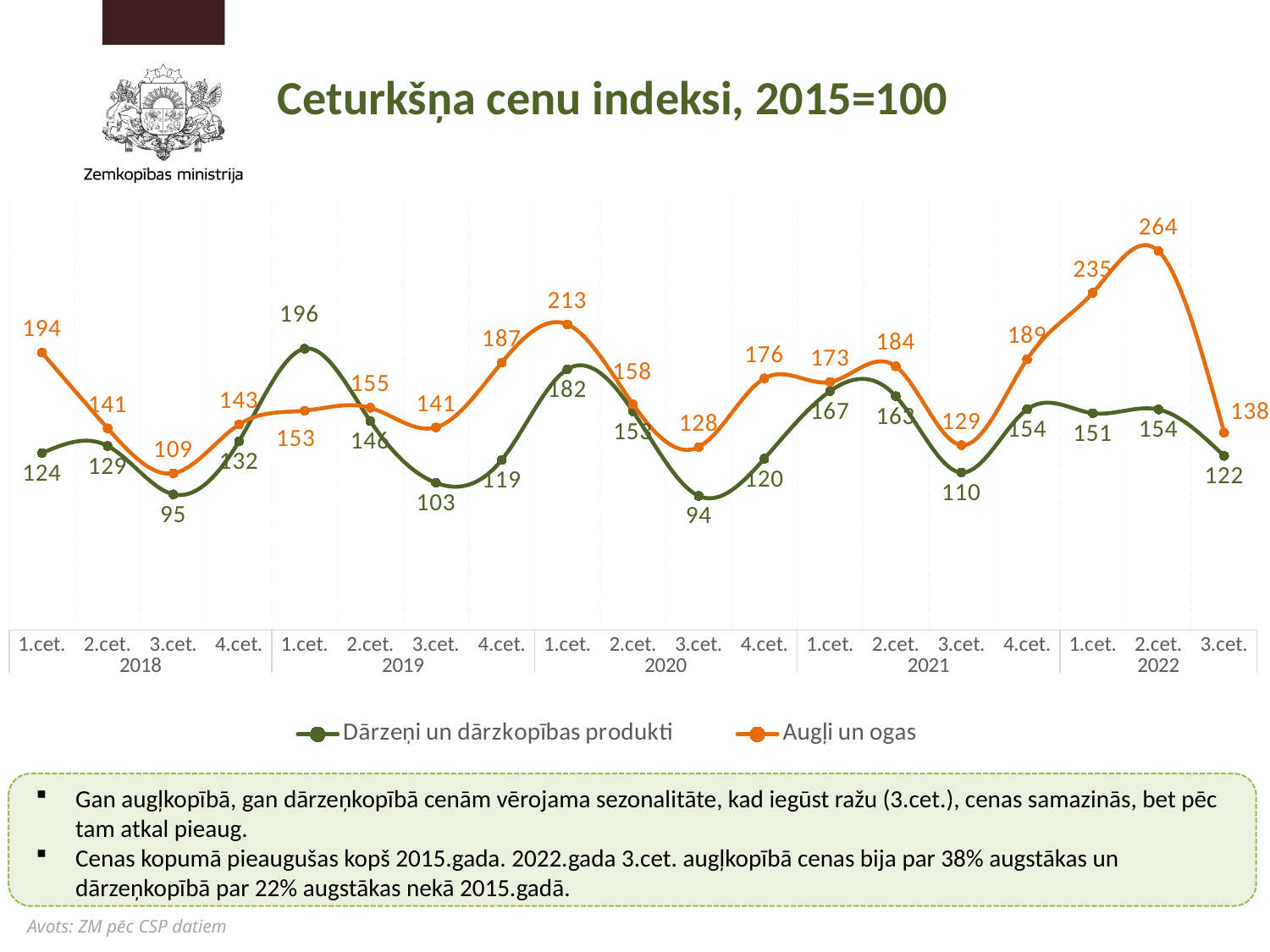
In which quarter does Augļi un ogas reach its highest value? 2.cet. 2022 What is the title of the chart? Ceturkšņa cenu indeksi, 2015=100 What is the value for Augļi un ogas in 2.cet. 2022? 264 What type of chart is shown on the slide? line chart What is the value for Dārzeņi un dārzkopības produkti in 3.cet. 2022? 122 How many series does the legend list? 2 How many quarterly data points are plotted for each series? 19 In which quarter does Dārzeņi un dārzkopības produkti reach its lowest value? 3.cet. 2020 What is the difference between Augļi un ogas and Dārzeņi un dārzkopības produkti in 1.cet. 2018? 70 Which series has the higher value in 1.cet. 2019, Dārzeņi un dārzkopības produkti or Augļi un ogas? Dārzeņi un dārzkopības produkti What is the value for Dārzeņi un dārzkopības produkti in 1.cet. 2019? 196 How does the Augļi un ogas value change from 2.cet. 2022 to 3.cet. 2022? It falls from 264 to 138